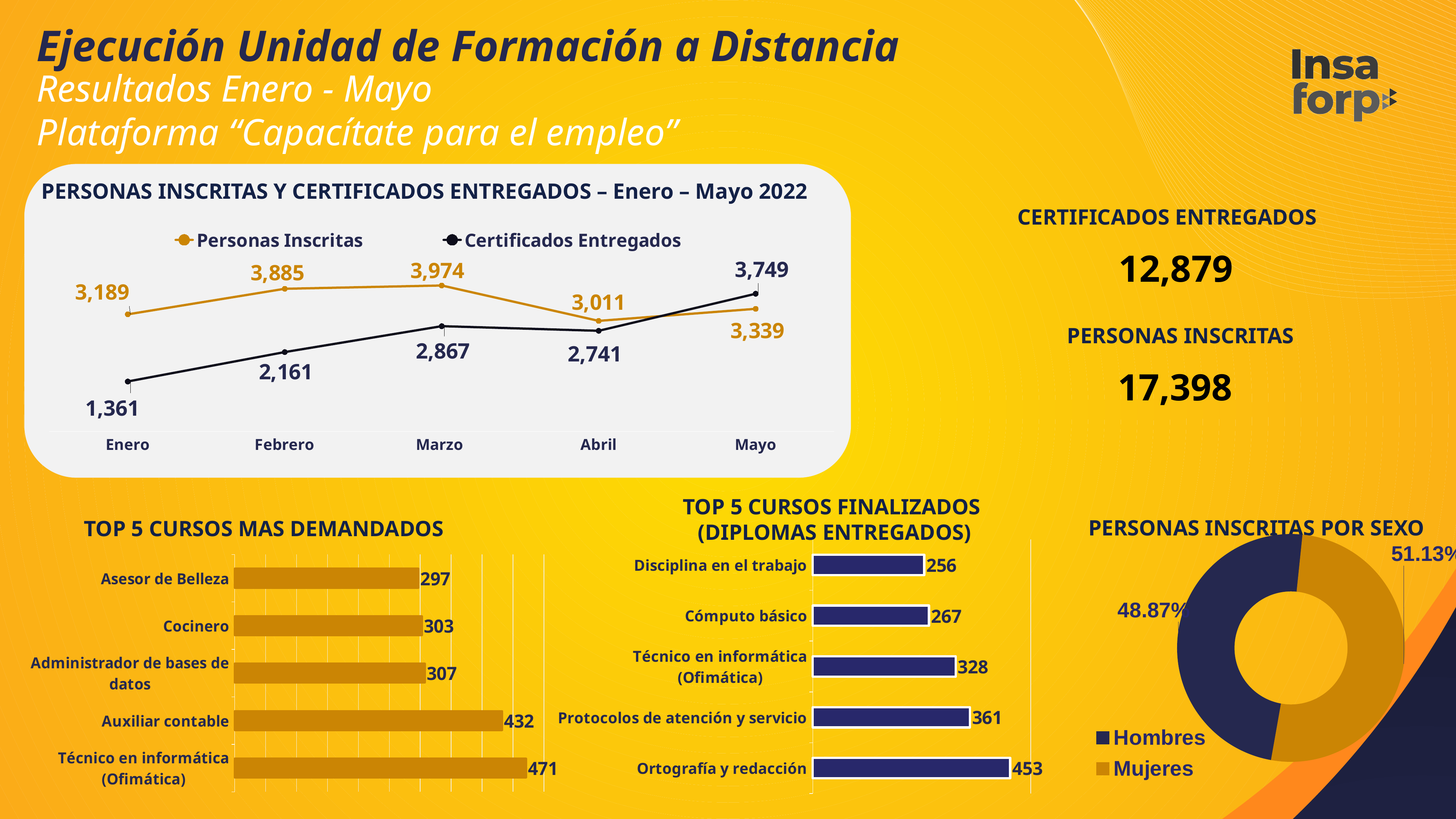
In the line chart 'Personas Inscritas y Certificados Entregados', what is the value of Certificados Entregados in Enero? 1,361 In the line chart 'Personas Inscritas y Certificados Entregados', does Certificados Entregados rise or fall from Enero to Marzo? rise In the line chart 'Personas Inscritas y Certificados Entregados', what is the difference between Personas Inscritas and Certificados Entregados in Febrero? 1,724 What kind of chart is 'Top 5 Cursos Mas Demandados'? bar chart In the chart 'Top 5 Cursos Mas Demandados', which course has the lowest value? Asesor de Belleza In the chart 'Top 5 Cursos Finalizados (Diplomas Entregados)', which is larger: Cómputo básico or Técnico en informática (Ofimática)? Técnico en informática (Ofimática) In the line chart 'Personas Inscritas y Certificados Entregados', in which month is Certificados Entregados highest? Mayo In the line chart 'Personas Inscritas y Certificados Entregados', how many series does the legend list? 2 In the chart 'Top 5 Cursos Finalizados (Diplomas Entregados)', what is the value for Protocolos de atención y servicio? 361 In the chart 'Personas Inscritas por Sexo', what share of the donut is Mujeres? 51.13% In the chart 'Top 5 Cursos Mas Demandados', what is the value for Auxiliar contable? 432 In the line chart 'Personas Inscritas y Certificados Entregados', what is the value of Personas Inscritas in Marzo? 3,974